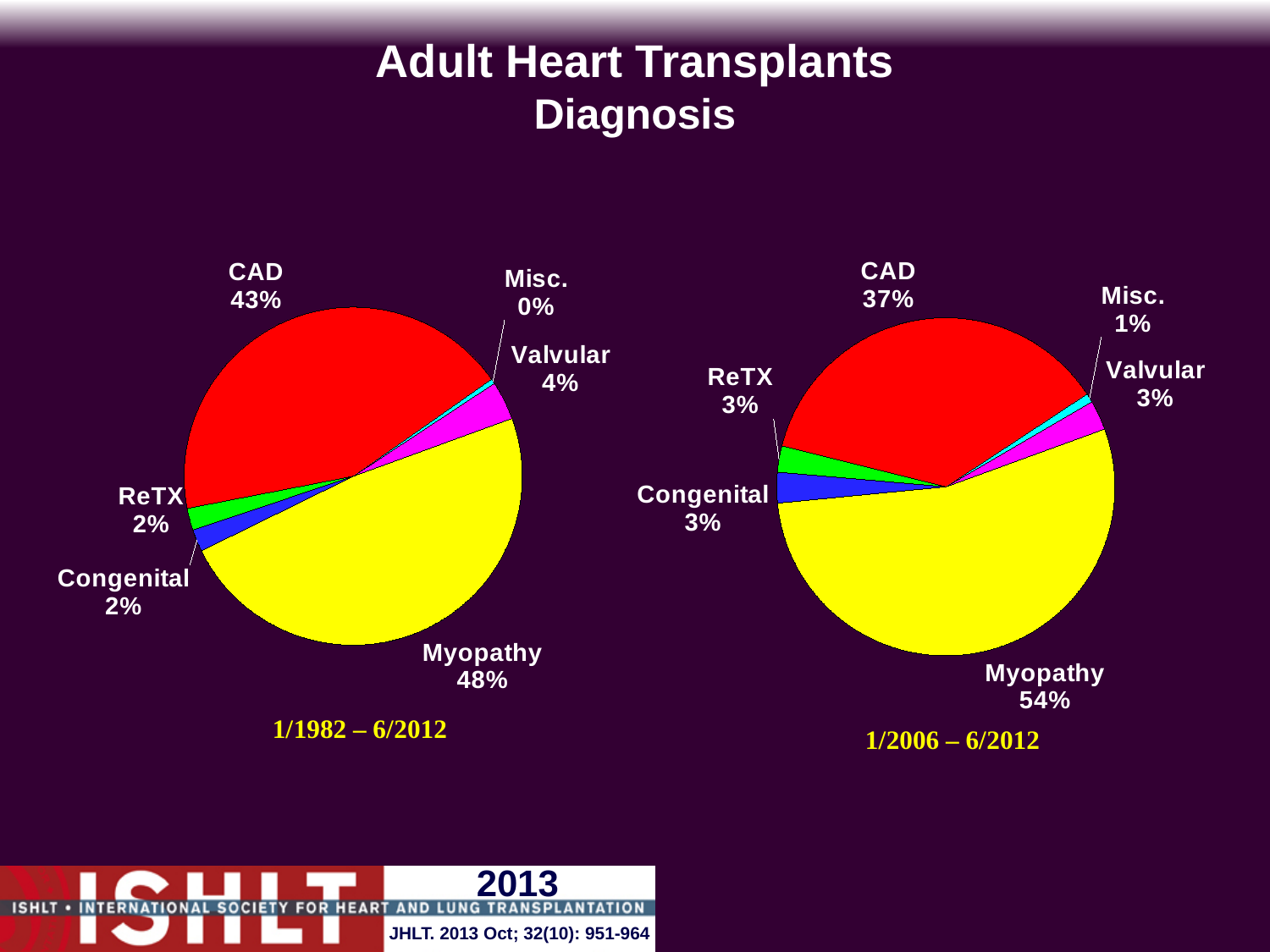
In the 1/2006 – 6/2012 pie chart, what percentage is shown for Valvular? 3% In the 1/1982 – 6/2012 pie chart, what share of adult heart transplants had a diagnosis of CAD? 43% What colour is the Myopathy slice in both pie charts? Yellow Which pie chart shows a larger share for CAD, the 1/1982 – 6/2012 chart or the 1/2006 – 6/2012 chart? 1/1982 – 6/2012 How many diagnosis categories are shown in the 1/2006 – 6/2012 pie chart? 6 What type of chart is used on this slide to show the diagnosis distribution? Pie chart In the 1/1982 – 6/2012 pie chart, which diagnosis has the largest share? Myopathy In the 1/1982 – 6/2012 pie chart, how many percentage points larger is Myopathy than CAD? 5 In the 1/2006 – 6/2012 pie chart, how many percentage points larger is Myopathy than CAD? 17 In the 1/2006 – 6/2012 pie chart, what share of adult heart transplants had a diagnosis of Myopathy? 54% In the 1/2006 – 6/2012 pie chart, which diagnosis has the smallest share? Misc. In the 1/1982 – 6/2012 pie chart, what percentage is shown for Misc.? 0%